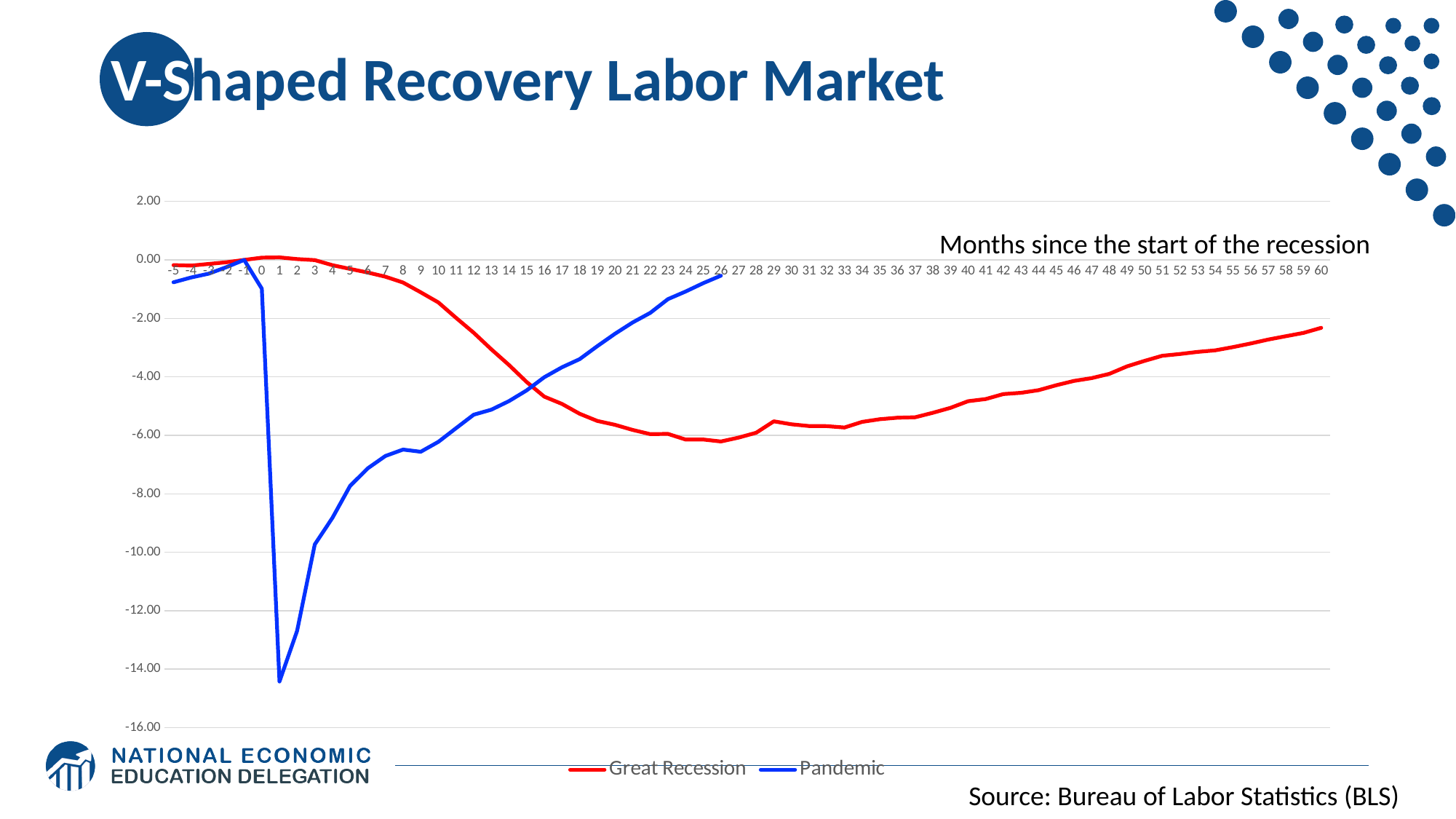
Is the value of the Great Recession series at month 60 greater or less than -4.00? greater What kind of chart is shown on the slide? line chart What are the two series named in the legend? Great Recession and Pandemic Is the value of the Pandemic series at month 3 greater or less than -8.00? less Does the Great Recession series rise or fall between month 30 and month 60? rise At month 20, which series has the higher value, Great Recession or Pandemic? Pandemic At month 10, which series has the lower value, Great Recession or Pandemic? Pandemic What is the label given for the x axis? Months since the start of the recession Is the lowest value of the Pandemic series greater or less than -12.00? less Which series reaches the lowest value on the chart? Pandemic How many series does the legend list? 2